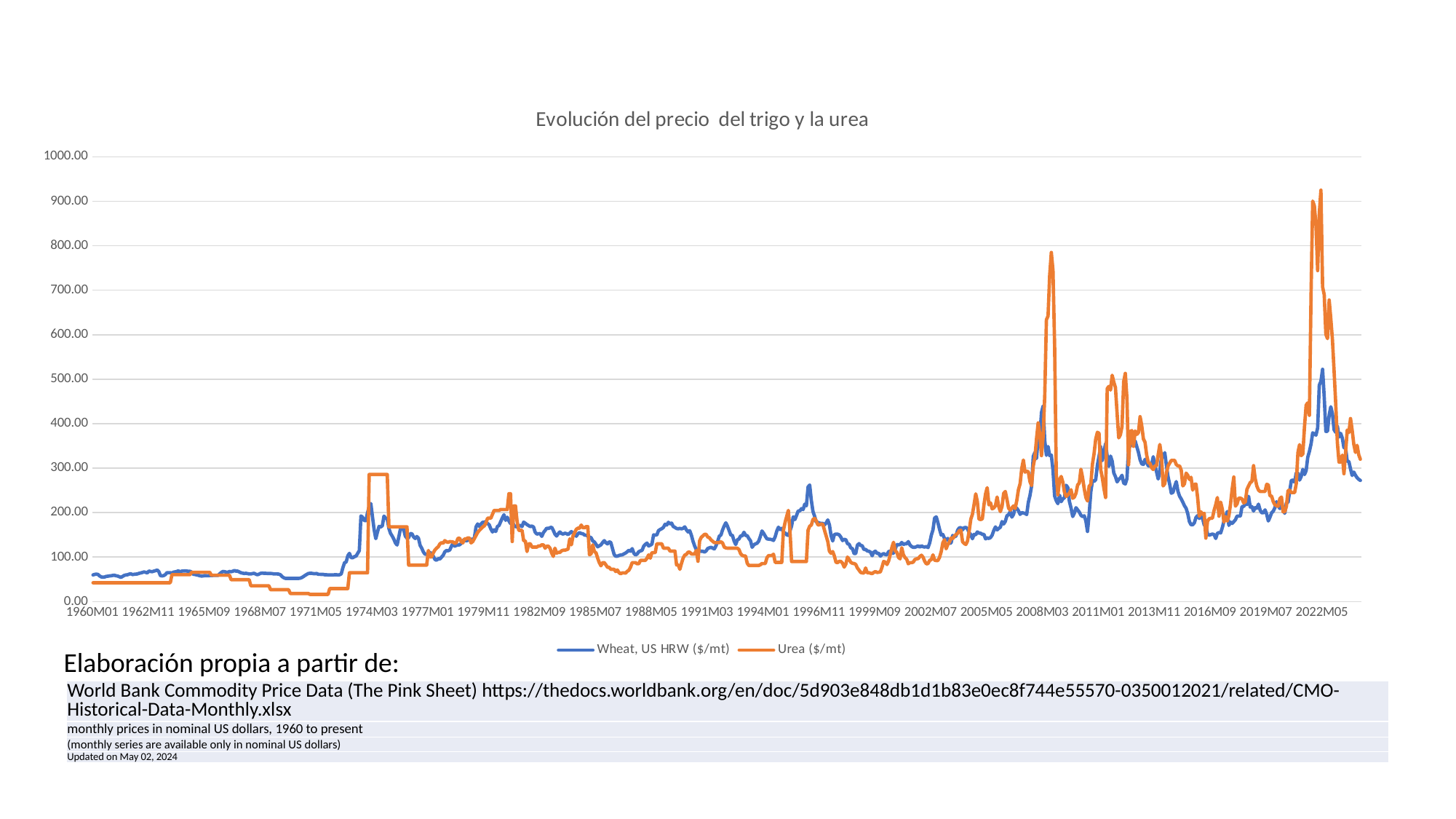
What is the title of the chart? Evolución del precio del trigo y la urea Overall, do the prices rise or fall from 1960M01 to 2022M05? rise What kind of chart is shown on the slide? line chart How many series does the legend list? 2 Which colour is used for the Urea ($/mt) series? orange What is the highest value shown on the y axis? 1000.00 Which series reaches the highest value on the chart, Wheat, US HRW ($/mt) or Urea ($/mt)? Urea ($/mt) Is the highest value of the Wheat, US HRW ($/mt) series greater or less than 400? greater Is the value of Urea ($/mt) around 1971M05 greater or less than 100? less Is the highest value of the Urea ($/mt) series greater or less than 800? greater Around 2008M03, which series has the higher peak, Wheat, US HRW ($/mt) or Urea ($/mt)? Urea ($/mt)